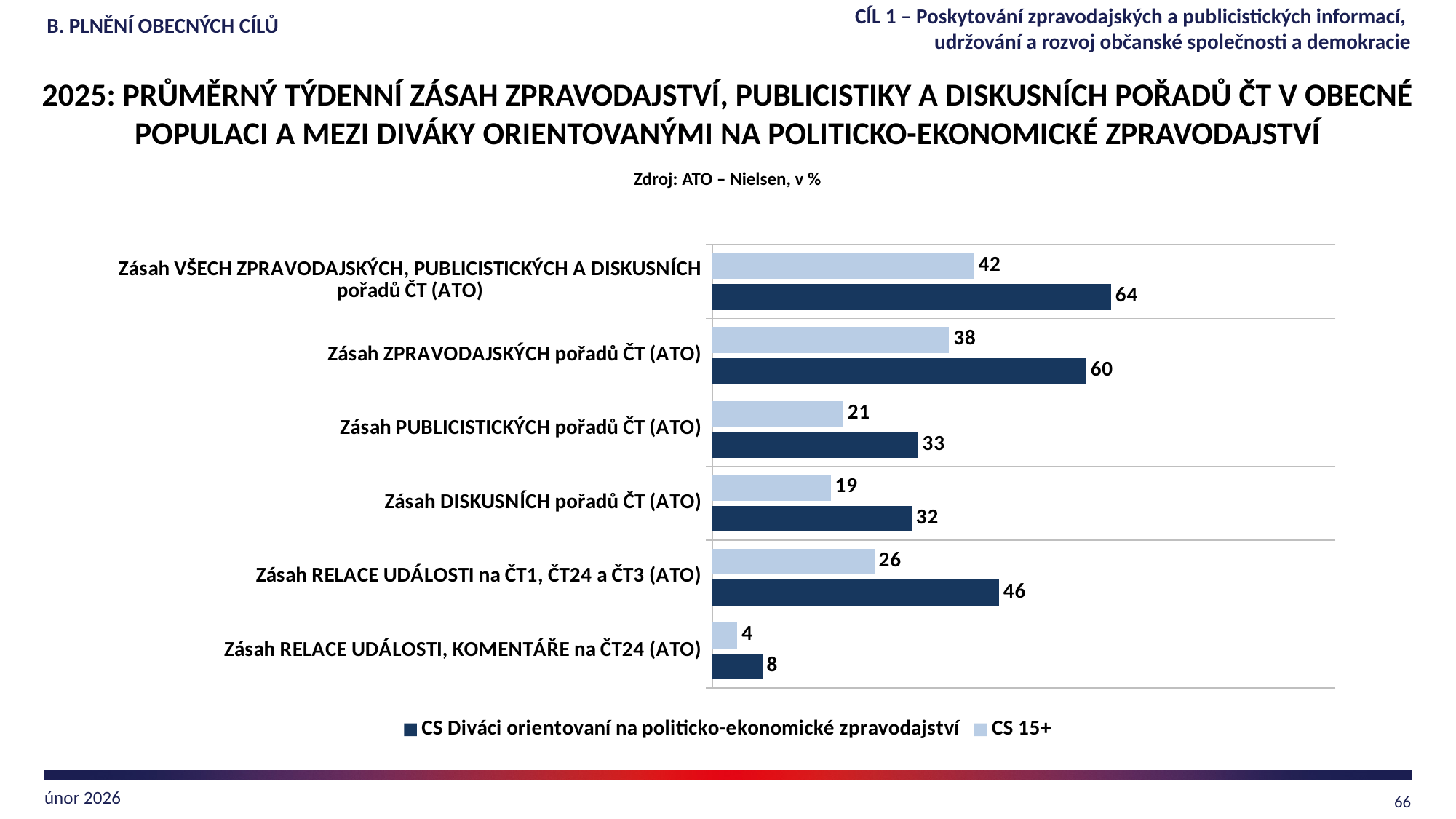
What is the value for 'CS Diváci orientovaní na politicko-ekonomické zpravodajství' for 'Zásah DISKUSNÍCH pořadů ČT (ATO)'? 32 Which category has the lowest value for 'CS 15+'? Zásah RELACE UDÁLOSTI, KOMENTÁŘE na ČT24 (ATO) Which is larger: the 'CS 15+' value for 'Zásah VŠECH ZPRAVODAJSKÝCH, PUBLICISTICKÝCH A DISKUSNÍCH pořadů ČT (ATO)' or the 'CS Diváci orientovaní na politicko-ekonomické zpravodajství' value for 'Zásah PUBLICISTICKÝCH pořadů ČT (ATO)'? CS 15+ for Zásah VŠECH ZPRAVODAJSKÝCH, PUBLICISTICKÝCH A DISKUSNÍCH pořadů ČT (ATO) What is the difference between the 'CS 15+' values for 'Zásah PUBLICISTICKÝCH pořadů ČT (ATO)' and 'Zásah DISKUSNÍCH pořadů ČT (ATO)'? 2 Which category has the highest value for 'CS Diváci orientovaní na politicko-ekonomické zpravodajství'? Zásah VŠECH ZPRAVODAJSKÝCH, PUBLICISTICKÝCH A DISKUSNÍCH pořadů ČT (ATO) What is the difference between the two series for 'Zásah RELACE UDÁLOSTI na ČT1, ČT24 a ČT3 (ATO)'? 20 What is the source stated below the chart title? ATO – Nielsen, v % What is the value for 'CS 15+' for 'Zásah ZPRAVODAJSKÝCH pořadů ČT (ATO)'? 38 How many series does the legend list? 2 What kind of chart is shown on the slide? Bar chart How many categories are shown on the chart? 6 What is the value for 'CS 15+' for 'Zásah RELACE UDÁLOSTI, KOMENTÁŘE na ČT24 (ATO)'? 4